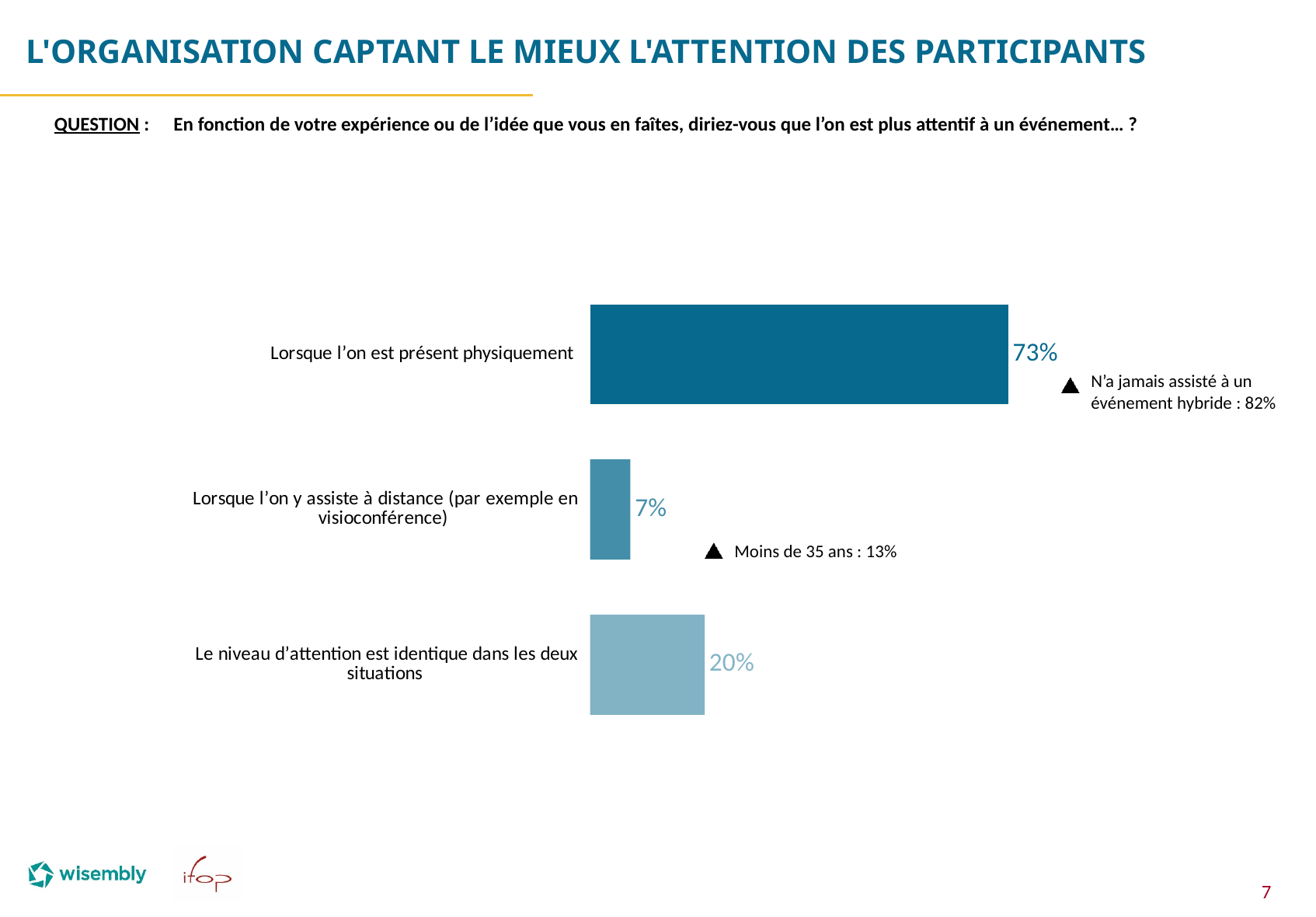
What is the difference between the values for "Le niveau d'attention est identique dans les deux situations" and "Lorsque l'on y assiste à distance"? 13% What kind of chart is shown on the slide? Bar chart What is the difference between the values for "Lorsque l'on est présent physiquement" and "Le niveau d'attention est identique dans les deux situations"? 53% Which category has the lowest value? Lorsque l'on y assiste à distance (par exemple en visioconférence) What is the total of the three values shown in the chart? 100% What is the value for "Lorsque l'on y assiste à distance (par exemple en visioconférence)"? 7% Which is larger: the value for "Le niveau d'attention est identique dans les deux situations" or the value for "Lorsque l'on y assiste à distance"? Le niveau d'attention est identique dans les deux situations According to the annotation next to the top bar, what is the value for respondents who have never attended a hybrid event ("N'a jamais assisté à un événement hybride")? 82% What is the value for "Lorsque l'on est présent physiquement"? 73% How many categories are shown in the chart? 3 Which category has the highest value? Lorsque l'on est présent physiquement What is the value for "Le niveau d'attention est identique dans les deux situations"? 20%